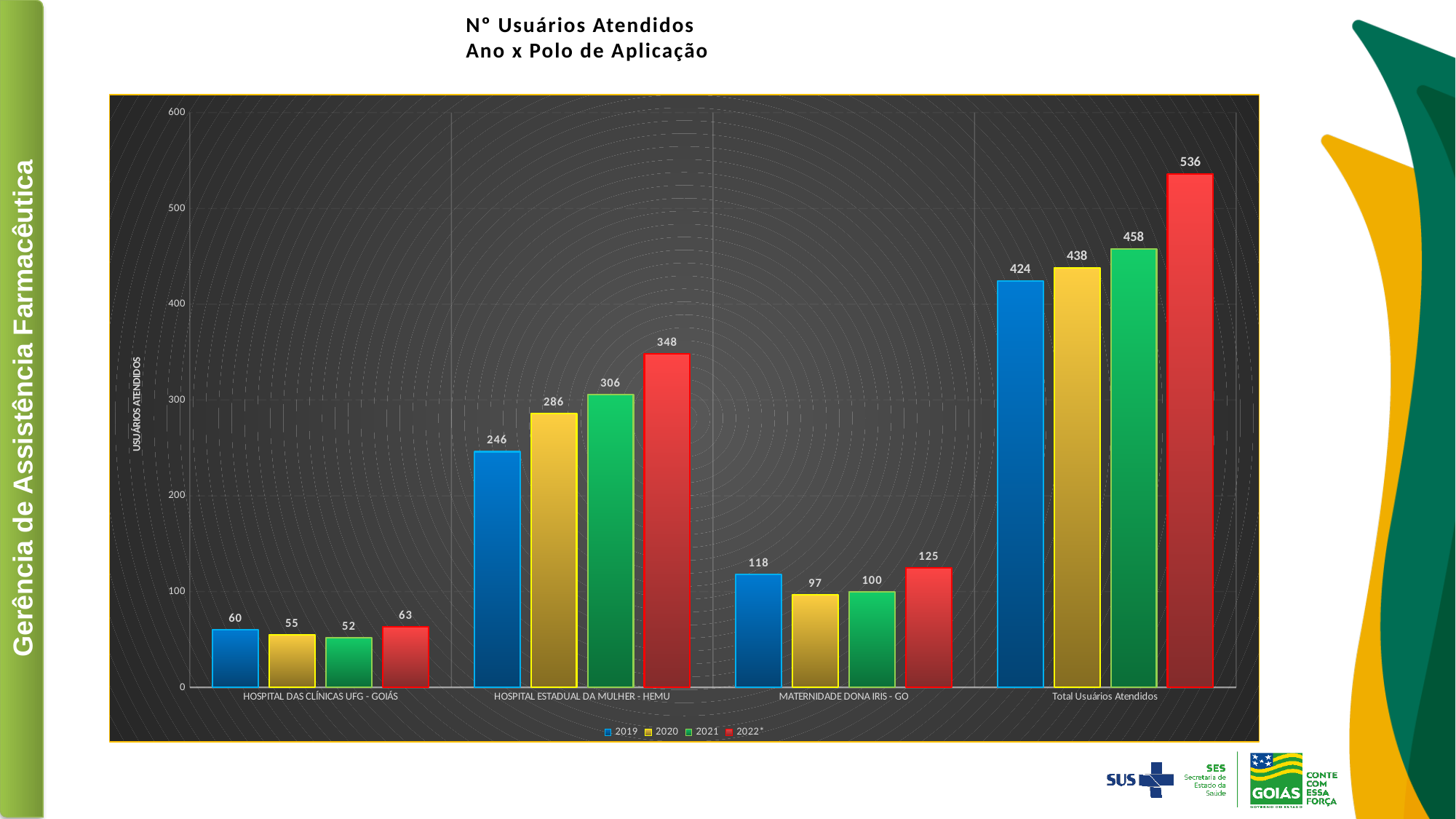
What is the value for Total Usuários Atendidos in 2021? 458 Which is larger for MATERNIDADE DONA IRIS - GO: the 2019 value or the 2022* value? 2022* What is the value for HOSPITAL DAS CLÍNICAS UFG - GOIÁS in 2020? 55 What is the value for MATERNIDADE DONA IRIS - GO in 2019? 118 What is the label of the vertical axis? USUÁRIOS ATENDIDOS What kind of chart is shown on the slide? Bar chart Which category has the highest value in the 2022* series? Total Usuários Atendidos How many categories are shown on the x axis? 4 Which category has the lowest value in the 2019 series? HOSPITAL DAS CLÍNICAS UFG - GOIÁS How many series does the legend list? 4 What is the value for HOSPITAL ESTADUAL DA MULHER - HEMU in 2022*? 348 What is the difference between the 2022* and 2019 values for Total Usuários Atendidos? 112